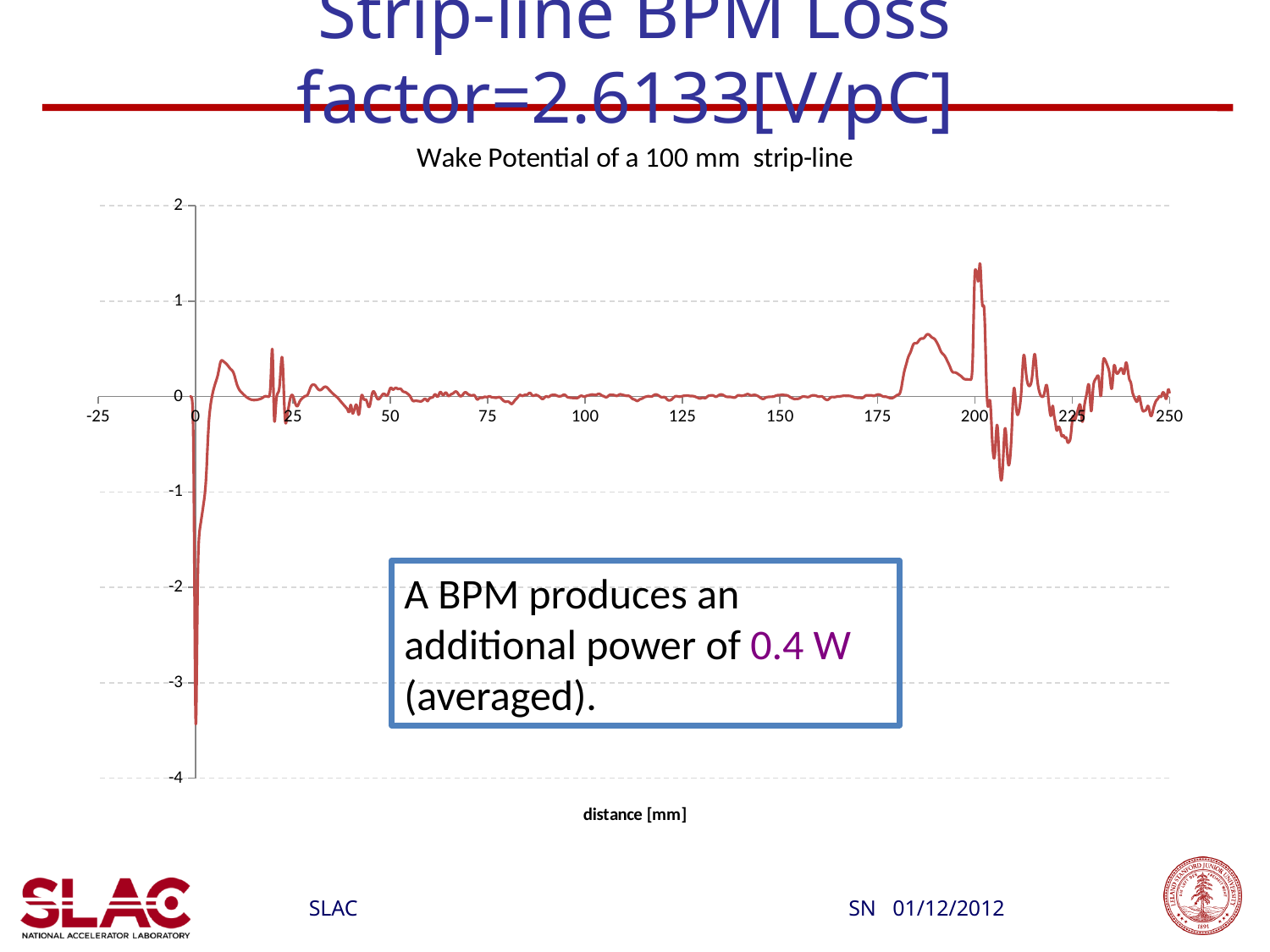
What is the label of the x axis of the chart? distance [mm] Is the peak of the wake potential near 200 mm greater or less than 1? greater What is the title of the chart? Wake Potential of a 100 mm strip-line Is the wake potential at 100 mm greater or less than -1? greater Which is lower, the minimum of the wake potential near 0 mm or the dip near 210 mm? the minimum near 0 mm Is the peak of the wake potential near 200 mm greater or less than 2? less Which is larger, the wake potential peak near 200 mm or the local peak near 185 mm? the peak near 200 mm What kind of chart is shown on the slide? line chart